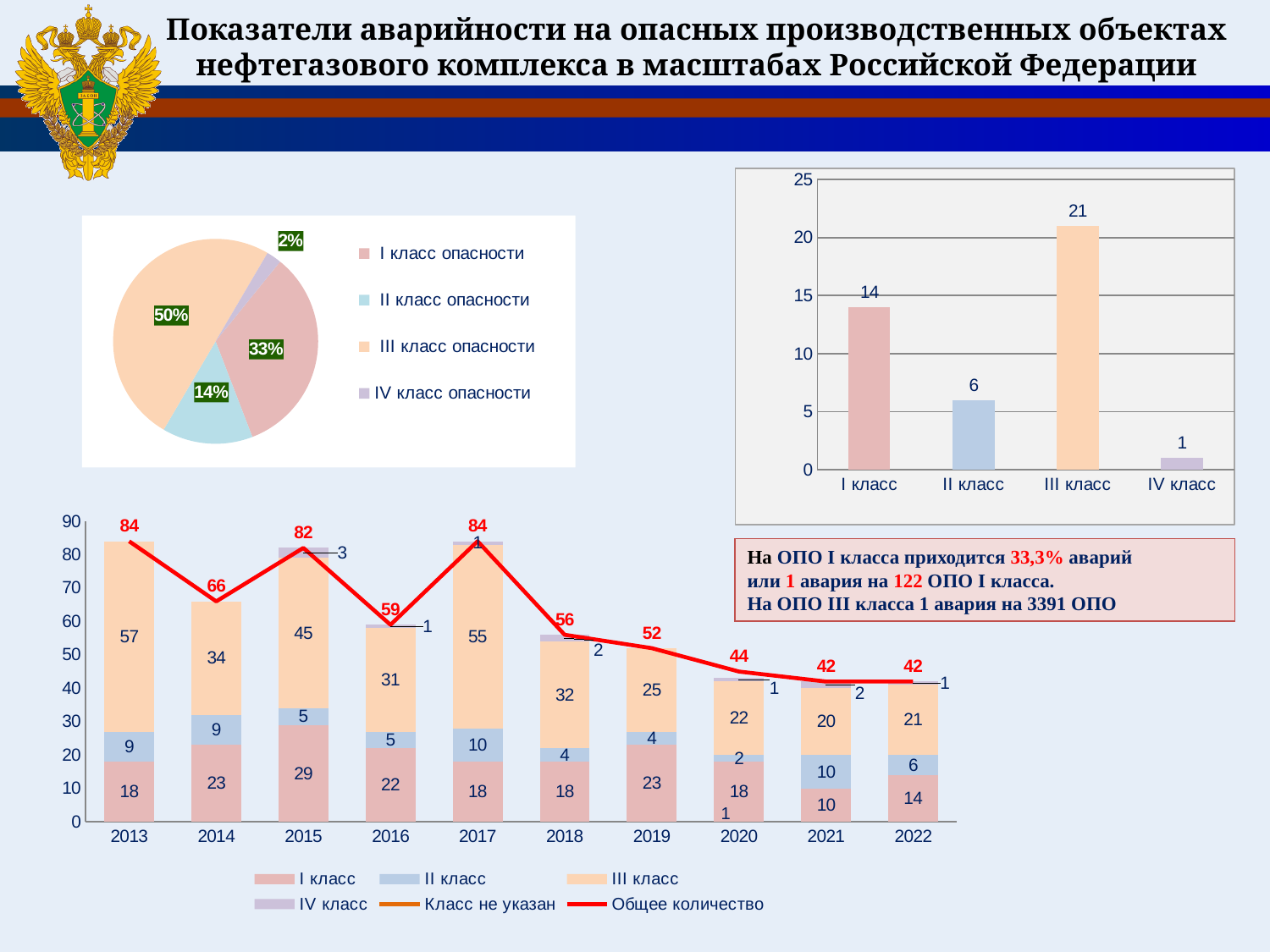
In the bottom chart, how many entries does the legend list? 6 In the bottom chart, what is the value of III класс for 2013? 57 In the pie chart on the left, what share does III класс опасности have? 50% In the bottom chart, which is larger: I класс in 2015 or I класс in 2021? 2015 In the bar chart at the top right, how many categories are shown on the x axis? 4 In the bar chart at the top right, what is the value for III класс? 21 In the pie chart on the left, what share does II класс опасности have? 14% In the bar chart at the top right, what is the difference between I класс and II класс? 8 In the bar chart at the top right, which category has the highest value? III класс In the bottom chart, does Общее количество rise or fall from 2017 to 2022? fall In the pie chart on the left, which category has the smallest share? IV класс опасности In the bottom chart, what is the value of Общее количество for 2016? 59